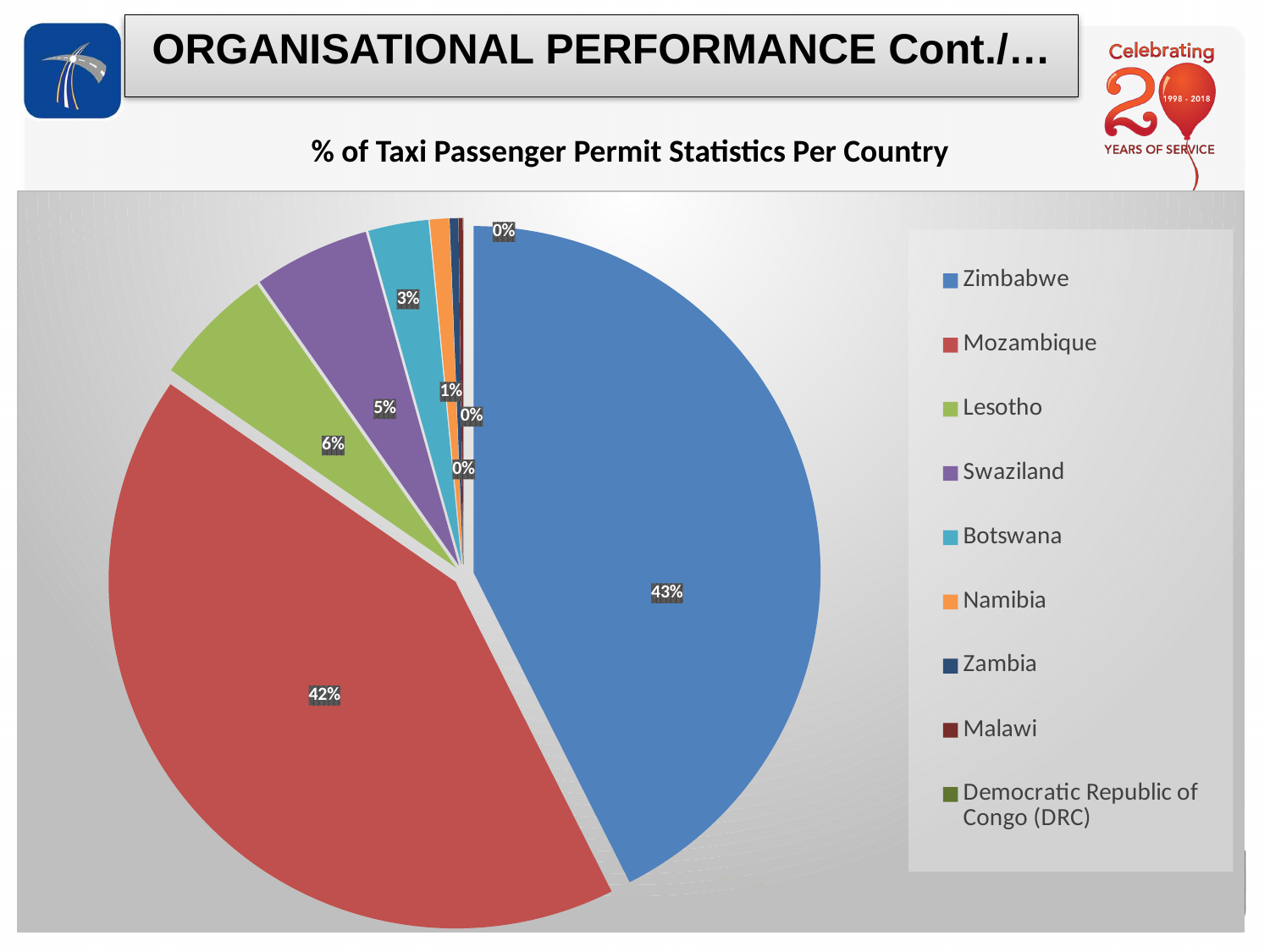
What percentage is shown for Swaziland? 5% Which has the larger share, Lesotho or Swaziland? Lesotho What share of the pie does Mozambique hold? 42% What is the difference in percentage points between Zimbabwe and Mozambique? 1% What kind of chart is shown on the slide? pie chart What percentage is shown for Namibia? 1% What percentage is shown for Lesotho? 6% What share of the pie does Zimbabwe hold? 43% How many countries are listed in the legend? 9 What percentage is shown for Botswana? 3% Which country has the largest share of the pie? Zimbabwe What is the title of the chart? % of Taxi Passenger Permit Statistics Per Country